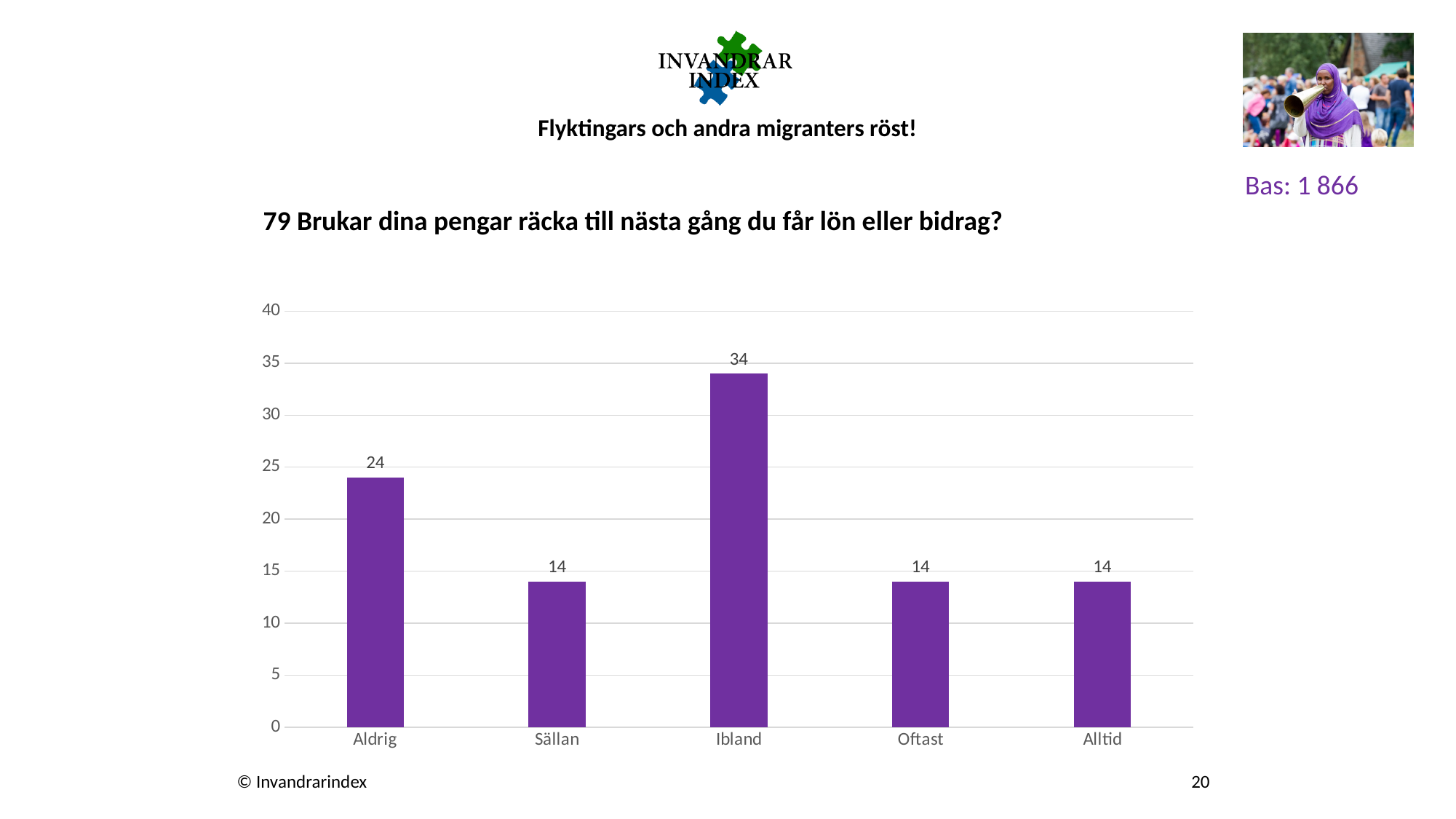
Which category has the highest value? Ibland What is the value for Ibland? 34 What is the difference between the values for Ibland and Aldrig? 10 Is the value for Ibland greater or less than 30? greater How many categories share the value 14? 3 What is the value for Aldrig? 24 How many categories are shown on the x axis? 5 Which is larger, the value for Aldrig or the value for Alltid? Aldrig What is the difference between the values for Aldrig and Oftast? 10 What kind of chart is shown on the slide? bar chart What is the base (Bas) shown on the slide? 1 866 What is the value for Sällan? 14